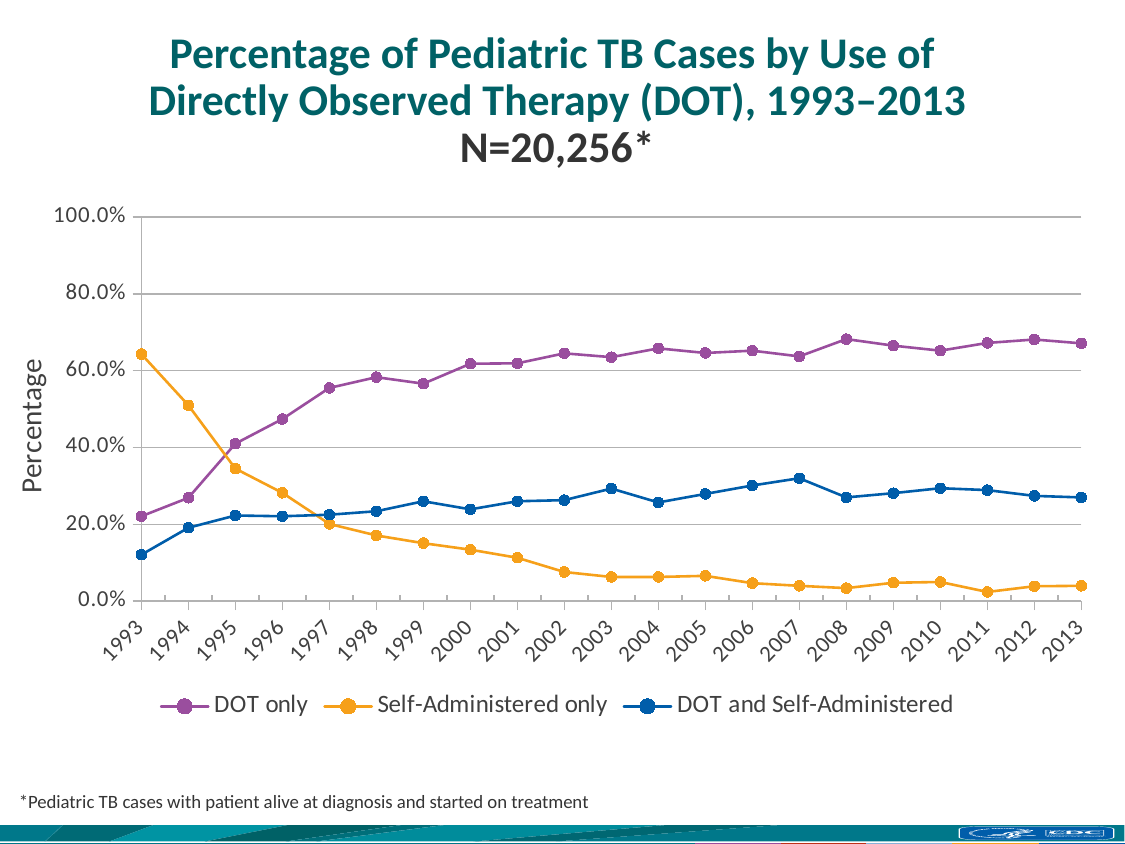
How many years are plotted along the x axis? 21 Is the value for DOT only in 2013 greater or less than 60.0%? greater Is the value for DOT and Self-Administered in 1993 greater or less than 20.0%? less Which series has the lowest value in 1993? DOT and Self-Administered How many series does the legend list? 3 Is the value for Self-Administered only in 2013 greater or less than 20.0%? less Does the Self-Administered only series rise or fall from 1993 to 2013? fall In 2013, which is larger: DOT only or Self-Administered only? DOT only In 1993, which is larger: Self-Administered only or DOT only? Self-Administered only Does the DOT only series rise or fall from 1993 to 2013? rise What is the N value stated in the chart title? N=20,256* What kind of chart is shown on the slide? line chart